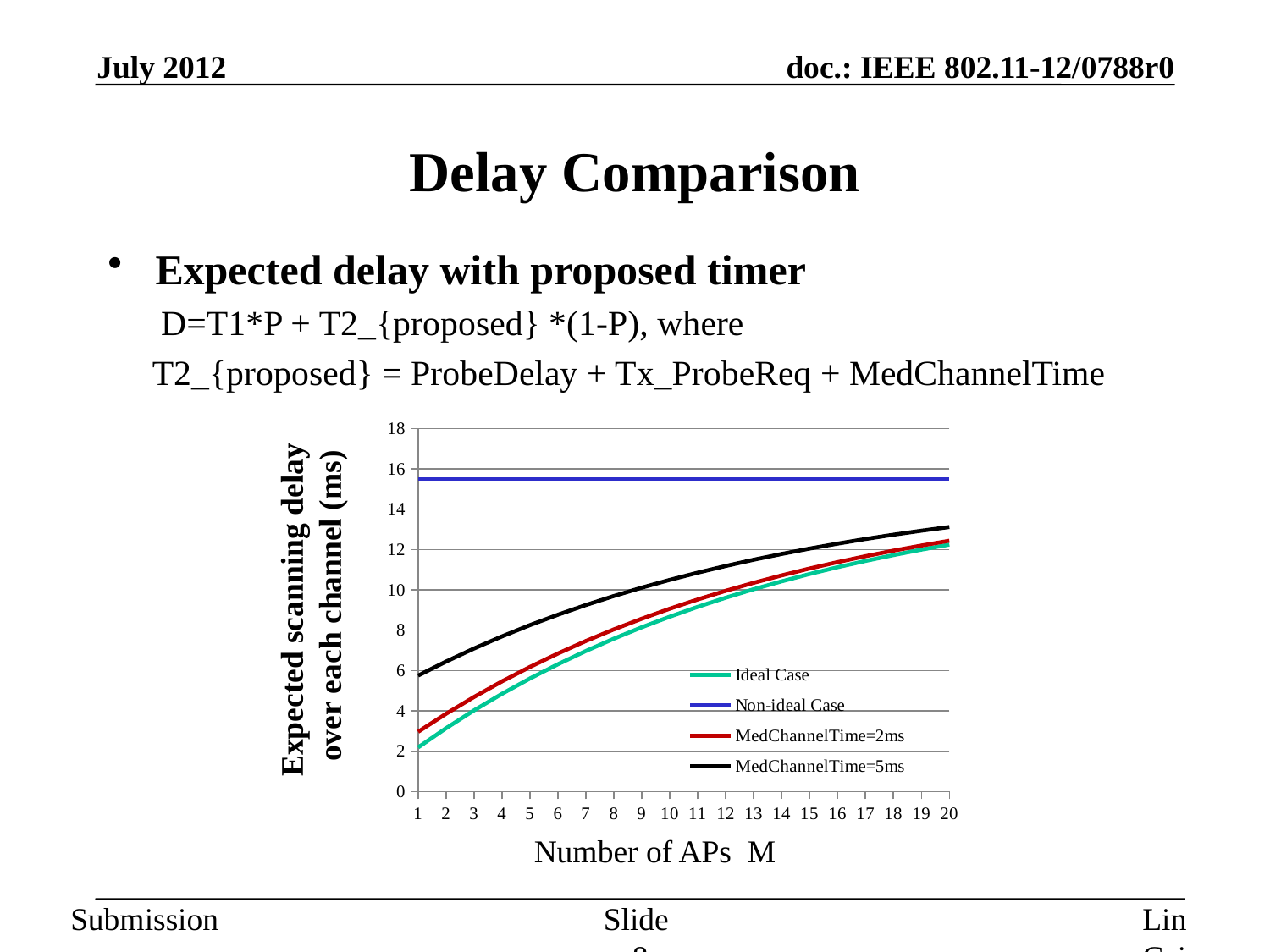
How many series does the chart legend list? 4 Does the Ideal Case delay rise or fall as the number of APs M increases? rise At M=5, which is larger: the Ideal Case or MedChannelTime=5ms? MedChannelTime=5ms What kind of chart is shown on the slide? line chart Is the value for MedChannelTime=2ms at M=20 greater or less than 10? greater Which series has the lowest expected scanning delay at M=1? Ideal Case Which series has the highest expected scanning delay across the whole range of M? Non-ideal Case Does the Non-ideal Case delay rise, fall, or stay flat as M increases? stay flat Is the value for the Non-ideal Case greater or less than 14? greater How many values of M (Number of APs) are plotted along the x axis? 20 What is the label of the x axis of the chart? Number of APs M Is the value for the Ideal Case at M=1 greater or less than 4? less